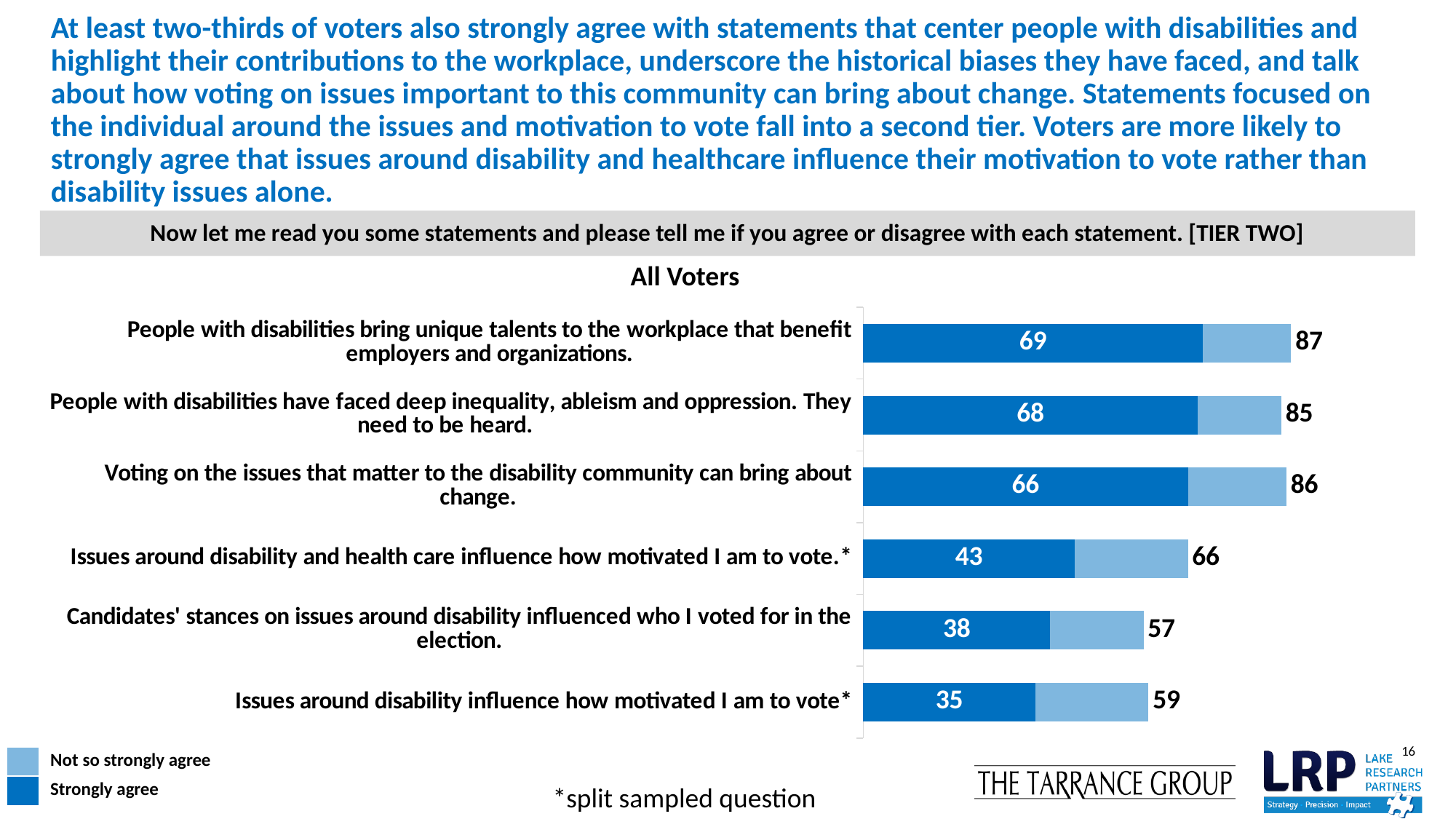
Which statement has the lowest total agreement value? Candidates' stances on issues around disability influenced who I voted for in the election. Which has a higher total agreement value: 'People with disabilities have faced deep inequality, ableism and oppression. They need to be heard.' or 'Voting on the issues that matter to the disability community can bring about change.'? Voting on the issues that matter to the disability community can bring about change. How many series does the legend list? 2 What kind of chart is shown on the slide? Stacked bar chart How many statements are plotted in the chart? 6 What is the title shown above the chart? All Voters What is the 'Not so strongly agree' value for 'Candidates' stances on issues around disability influenced who I voted for in the election.', given the strongly agree value of 38 and total of 57? 19 What is the difference between the strongly agree values for 'Issues around disability and health care influence how motivated I am to vote' and 'Issues around disability influence how motivated I am to vote'? 8 What is the strongly agree value for 'Issues around disability influence how motivated I am to vote'? 35 What is the total agreement value for the statement 'Voting on the issues that matter to the disability community can bring about change.'? 86 Which statement has the highest strongly agree value? People with disabilities bring unique talents to the workplace that benefit employers and organizations. What percentage of voters strongly agree that people with disabilities bring unique talents to the workplace that benefit employers and organizations? 69